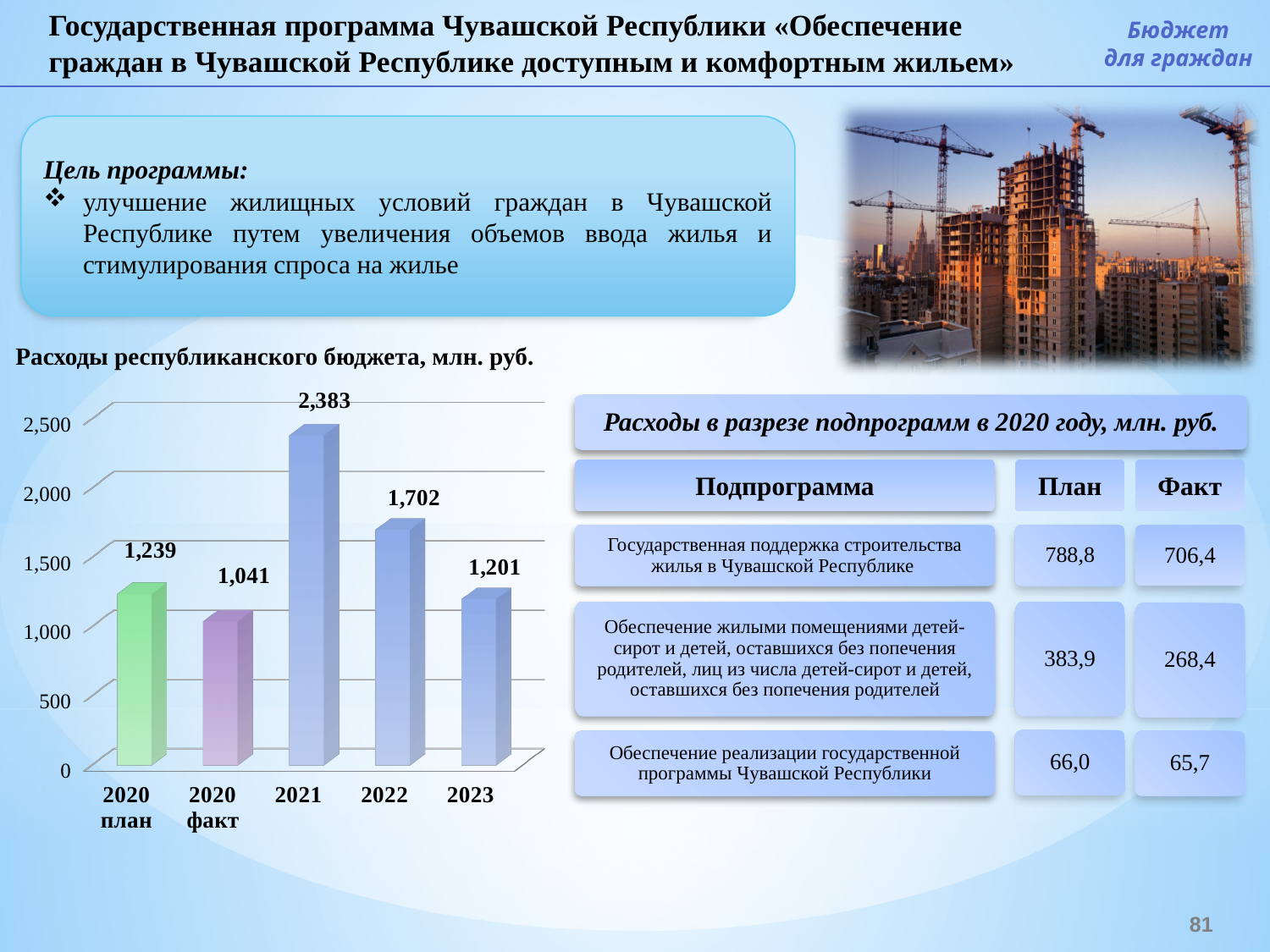
What kind of chart is shown on the slide? Bar chart What is the value for "2020 план" in the chart? 1,239 Which category has the lowest value in the chart? 2020 факт Which category has the highest value in the chart? 2021 What is the value for 2021 in the chart "Расходы республиканского бюджета, млн. руб."? 2,383 Which is larger in the chart: the value for 2022 or the value for 2023? 2022 What is the difference between "2020 план" and "2020 факт" in the chart? 198 What is the value for "2020 факт" in the chart? 1,041 How many bars are shown in the chart? 5 What is the value for 2023 in the chart? 1,201 What is the difference between the values for 2021 and 2022 in the chart? 681 What is the title of the chart on the slide? Расходы республиканского бюджета, млн. руб.